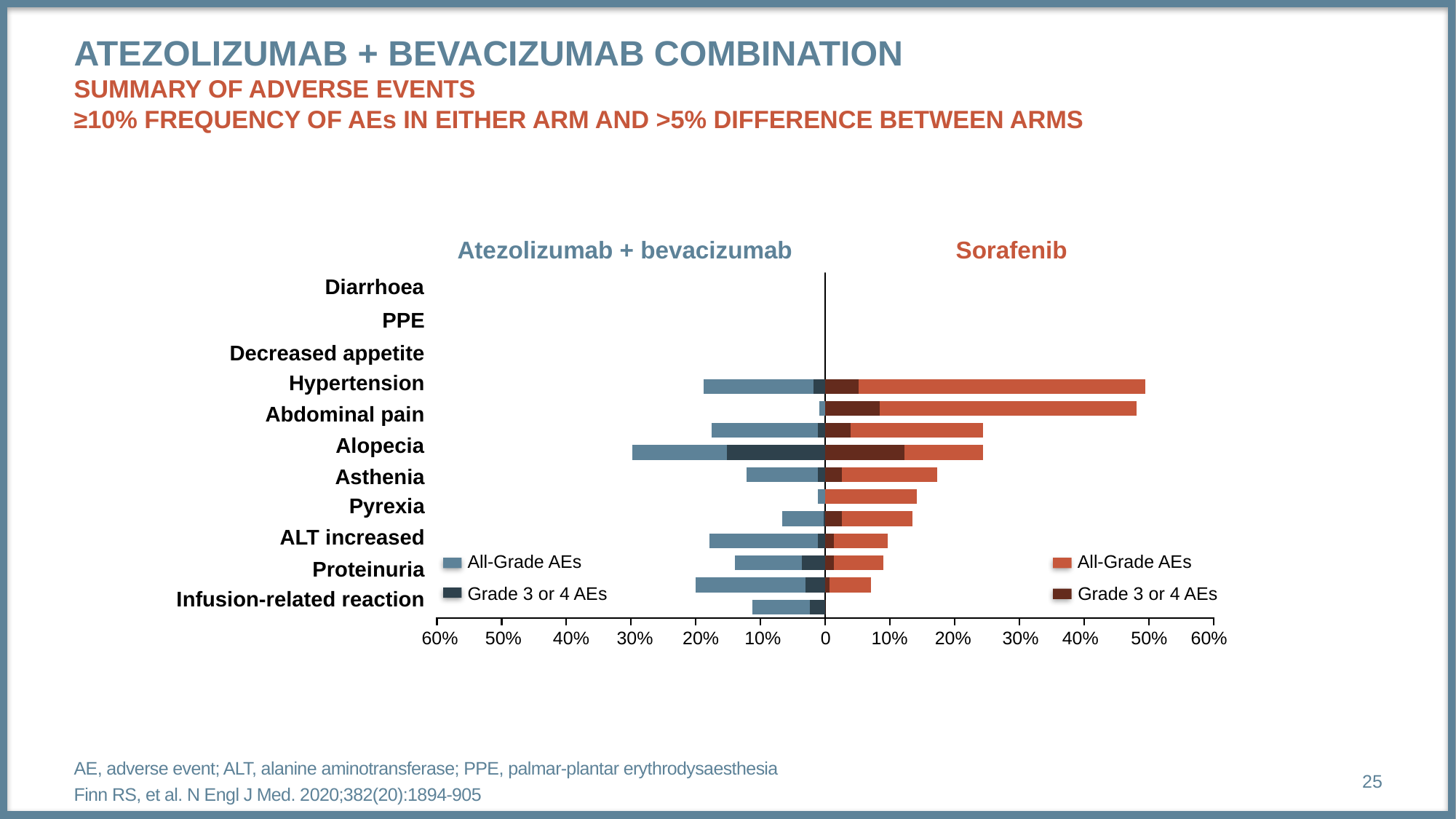
How many adverse event categories are listed on the y axis of the chart? 11 What kind of chart is shown on the slide? Bar chart Is the longest All-Grade AEs bar on the Atezolizumab + bevacizumab side greater or less than 40%? less What is the highest value shown on the x axis of the chart? 60% Which treatment arm is plotted on the left side of the chart? Atezolizumab + bevacizumab How many entries does the legend for the Sorafenib arm list? 2 Which arm has the longer longest All-Grade AEs bar, Atezolizumab + bevacizumab or Sorafenib? Sorafenib Is the longest All-Grade AEs bar on the Sorafenib side greater or less than 40%? greater How many entries does the legend for the Atezolizumab + bevacizumab arm list? 2